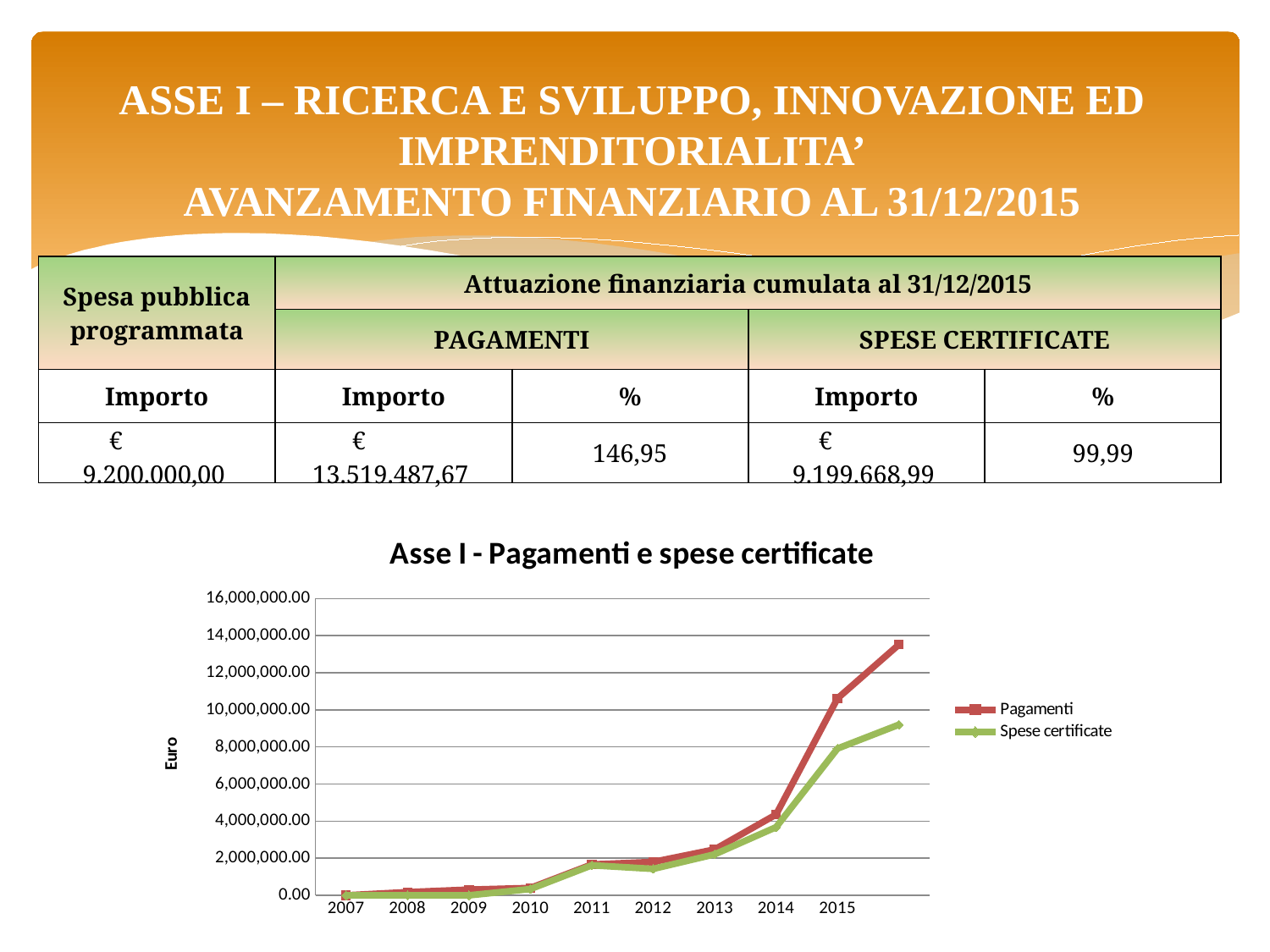
Is the value for Spese certificate at 2012 greater or less than 2,000,000.00? less Is the value for Pagamenti at 2015 greater or less than 10,000,000.00? greater Do the values of the Pagamenti series rise or fall from 2007 to 2015? rise Is the value for Pagamenti at 2013 greater or less than 2,000,000.00? greater Do the values of the Spese certificate series rise or fall along the x axis? rise What kind of chart is shown on the slide? line chart How many series does the chart legend list? 2 What is the title of the chart? Asse I - Pagamenti e spese certificate At 2015, which series has the larger value, Pagamenti or Spese certificate? Pagamenti Which series reaches the higher value at the end of the chart, Pagamenti or Spese certificate? Pagamenti What is the label on the vertical axis of the chart? Euro